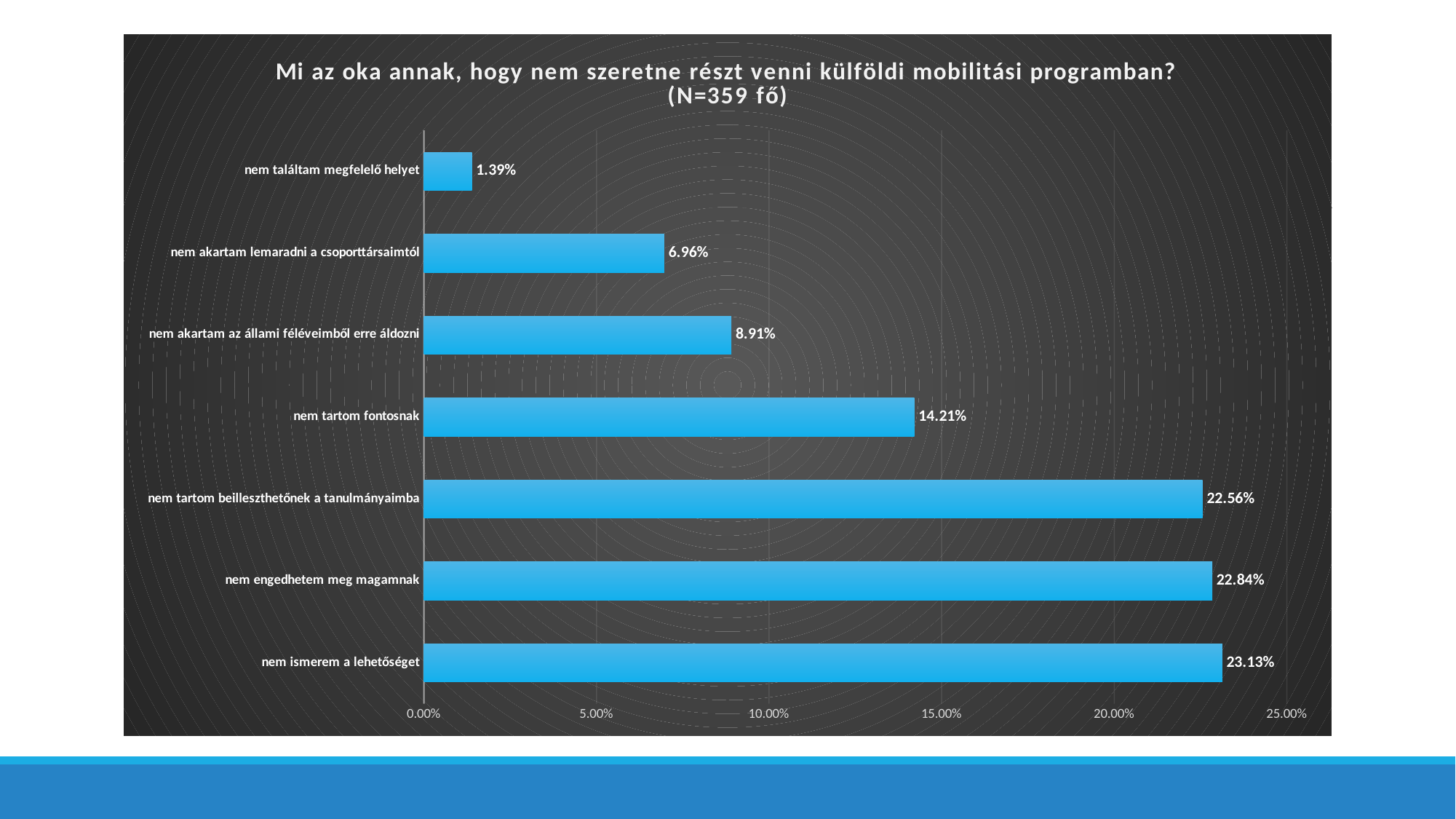
What is the value for "nem tartom fontosnak"? 14.21% What is the value for "nem ismerem a lehetőséget"? 23.13% What is the difference between the values for "nem tartom fontosnak" and "nem akartam az állami féléveimből erre áldozni"? 5.30% What is the sample size (N) stated in the chart title? 359 fő How many categories are shown in the chart? 7 What is the value for "nem akartam lemaradni a csoporttársaimtól"? 6.96% Is the value for "nem akartam az állami féléveimből erre áldozni" greater or less than 10.00%? less Which is larger: the value for "nem tartom fontosnak" or the value for "nem akartam lemaradni a csoporttársaimtól"? nem tartom fontosnak Which category has the lowest value? nem találtam megfelelő helyet What kind of chart is shown on the slide? bar chart What is the difference between the values for "nem engedhetem meg magamnak" and "nem tartom beilleszthetőnek a tanulmányaimba"? 0.28% Which category has the highest value? nem ismerem a lehetőséget